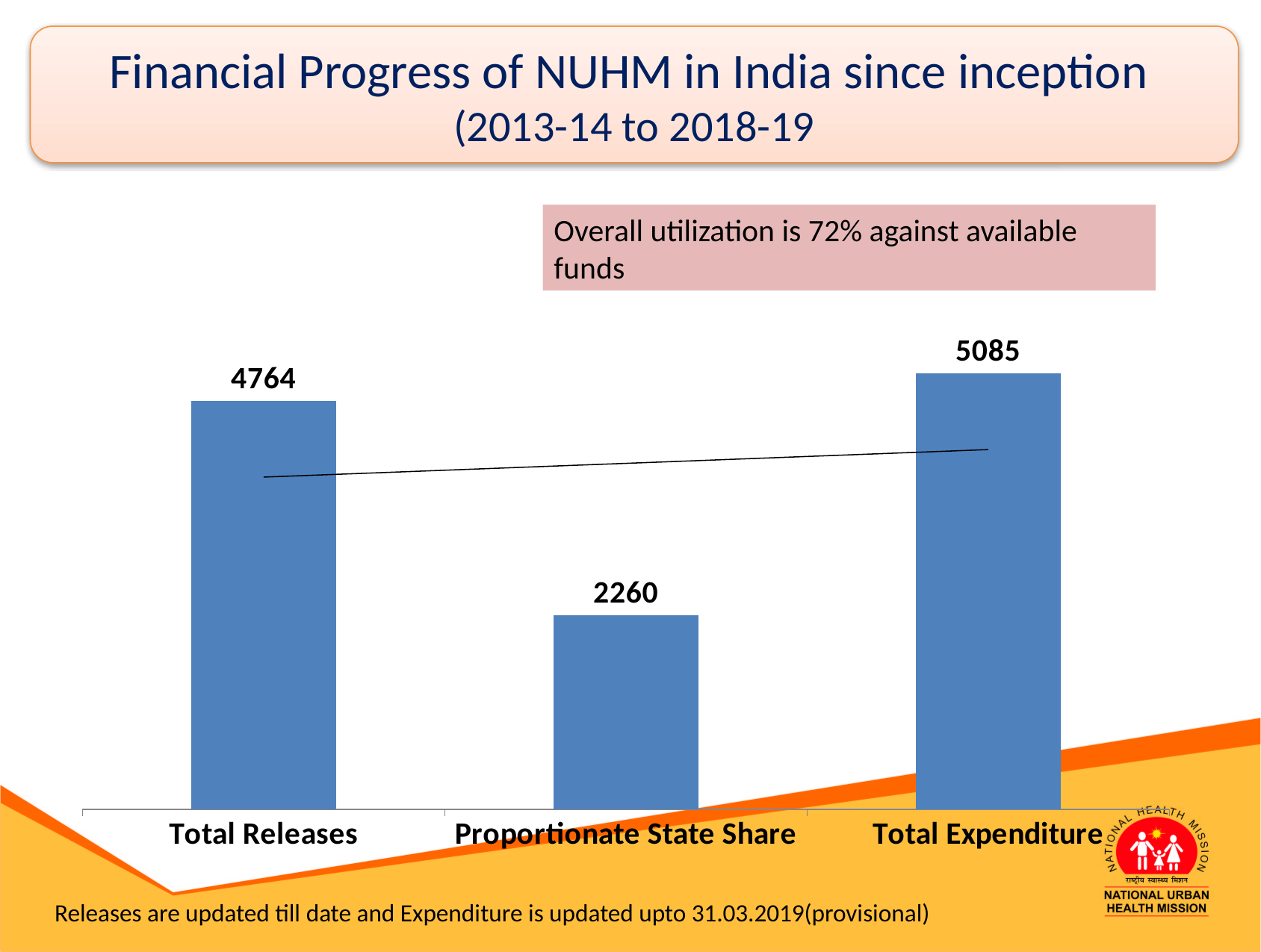
What is the value for Proportionate State Share? 2260 What is the difference between Total Releases and Proportionate State Share? 2504 Which category has the lowest value? Proportionate State Share What is the value for Total Releases? 4764 How many categories are shown in the chart? 3 Which category has the highest value? Total Expenditure According to the text box on the slide, what is the overall utilization against available funds? 72% What is the value for Total Expenditure? 5085 What is the difference between Total Expenditure and Total Releases? 321 Which is larger, Total Releases or Proportionate State Share? Total Releases What kind of chart is shown on the slide? Bar chart What is the title of the slide containing the chart? Financial Progress of NUHM in India since inception (2013-14 to 2018-19